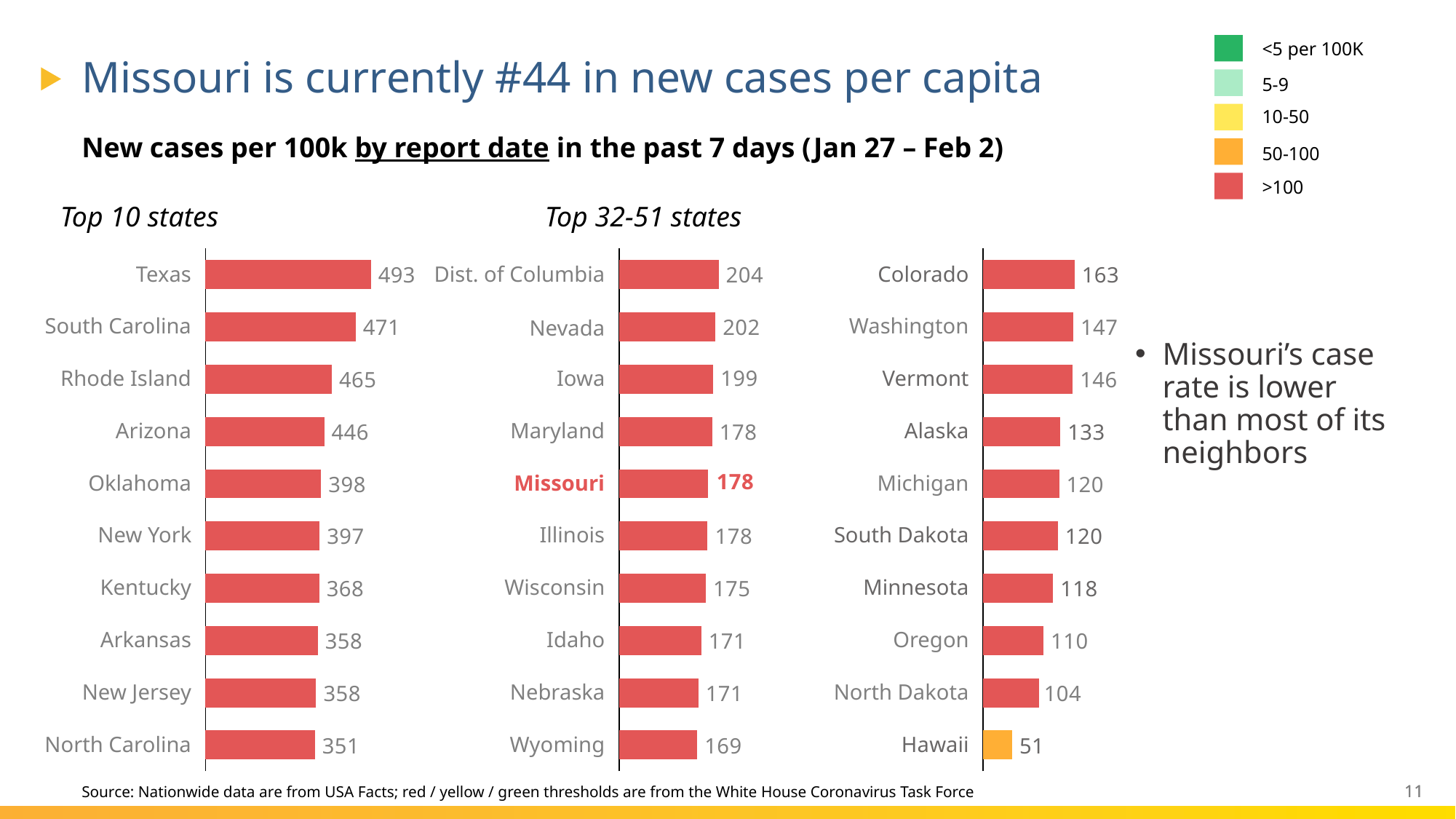
In the rightmost chart (Top 32-51 states, right column), which state has the highest value? Colorado In the middle chart (Top 32-51 states, left column), what is the value for Missouri? 178 In the Top 10 states chart, which state has the lowest value? North Carolina In the Top 10 states chart, what is the difference between Texas and South Carolina? 22 In the middle chart (Top 32-51 states, left column), which state has the highest value? Dist. of Columbia In the rightmost chart (Top 32-51 states, right column), what is the value for Hawaii? 51 What kind of chart is used on this slide? Bar chart In the Top 10 states chart, what is the value for Texas? 493 In the rightmost chart (Top 32-51 states, right column), which state's bar is coloured orange instead of red? Hawaii In the middle chart (Top 32-51 states, left column), which is larger, Nevada or Iowa? Nevada In the Top 10 states chart, how many states are shown? 10 In the rightmost chart (Top 32-51 states, right column), what is the difference between Colorado and Washington? 16